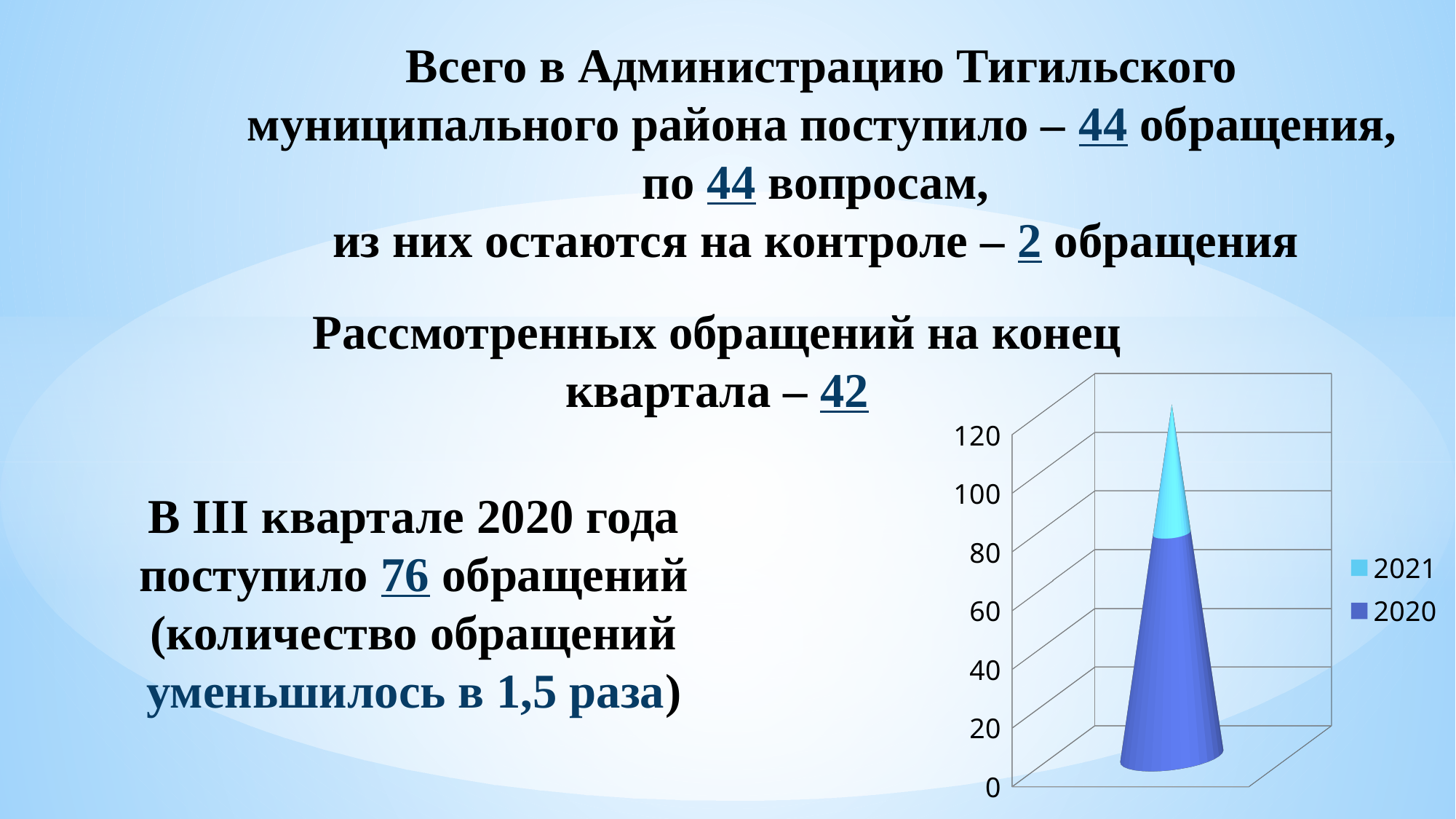
Is the value of the 2021 segment in the stacked bar greater or less than 60? less Which series are listed in the chart legend? 2021 and 2020 What kind of chart is shown on the slide? bar chart Is the total height of the stacked bar greater or less than 80? greater What is the highest tick value shown on the chart's vertical axis? 120 Which series occupies the larger portion of the stacked bar, 2020 or 2021? 2020 How many series does the chart legend list? 2 Which series is shown in the darker blue colour in the chart? 2020 Is the value of the 2020 segment in the stacked bar greater or less than 40? greater How many bars are plotted in the chart? 1